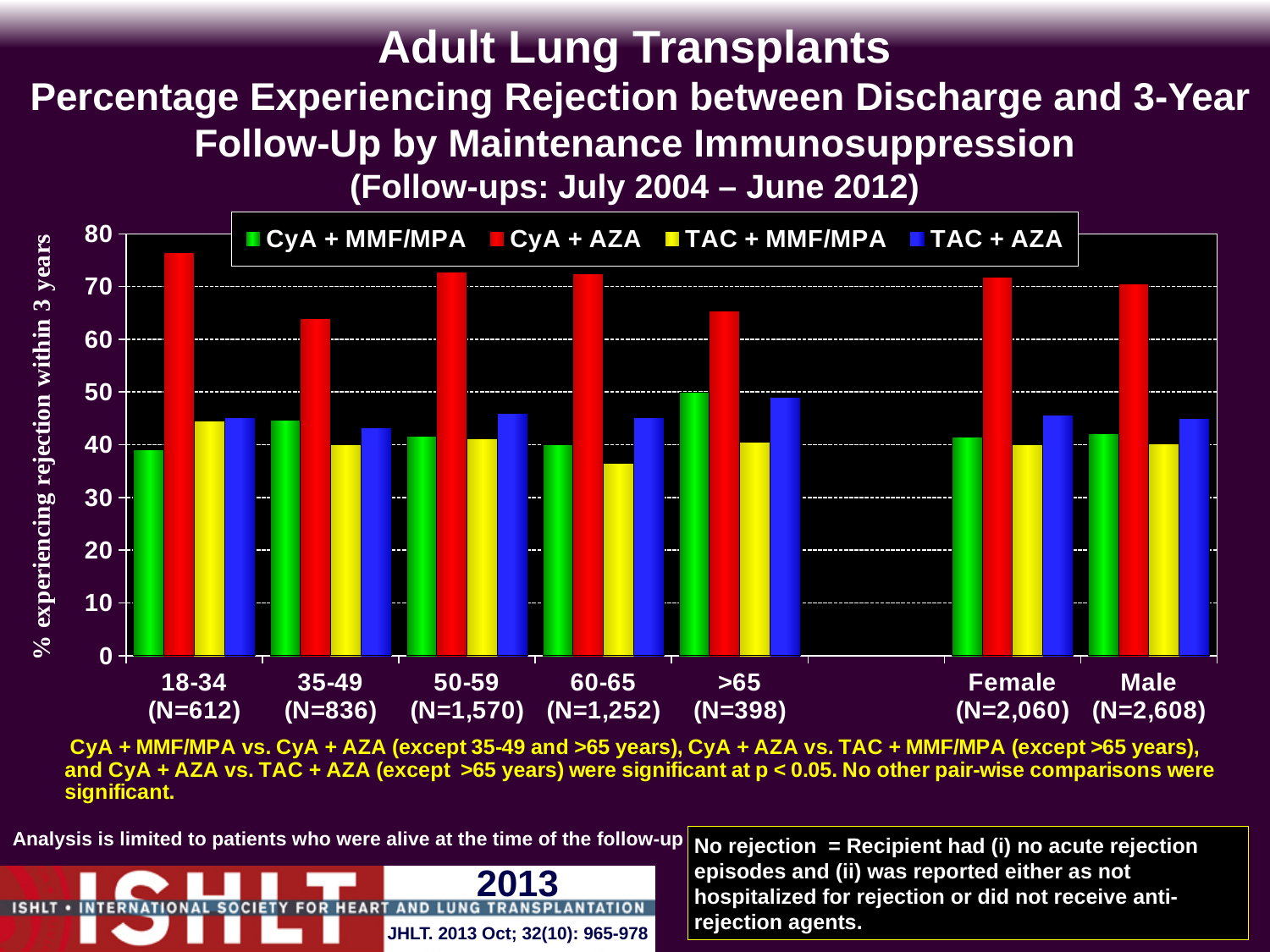
Which age group has the lowest value for TAC + MMF/MPA? 60-65 (N=1,252) Is the value for CyA + AZA in the 18-34 age group greater or less than 70? greater In the >65 age group, which is larger: CyA + MMF/MPA or TAC + MMF/MPA? CyA + MMF/MPA How many series does the legend list? 4 Which age group has the highest value for CyA + AZA? 18-34 (N=612) Is the value for TAC + AZA in the >65 age group greater or less than 40? greater What colour represents CyA + AZA in the legend? Red How many categories are shown along the x axis? 7 Which series has the highest value in every category? CyA + AZA Is the value for TAC + MMF/MPA in the 60-65 age group greater or less than 40? less What kind of chart is shown on the slide? Bar chart